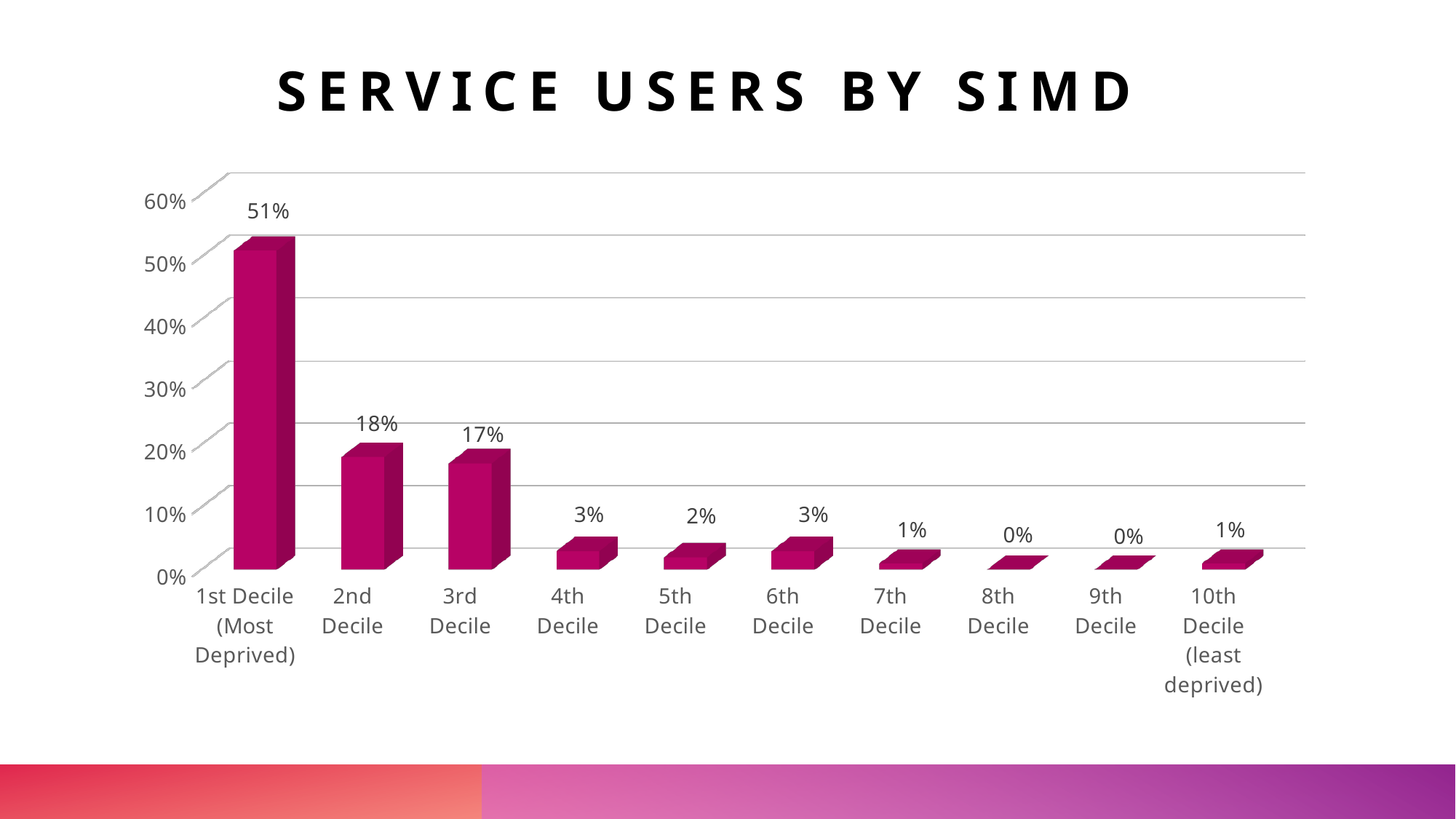
What kind of chart is shown on the slide? Bar chart Is the value for the 1st Decile greater or less than 50%? greater What percentage of service users are in the 1st Decile (Most Deprived)? 51% What is the difference between the values for the 2nd Decile and the 3rd Decile? 1% What is the value for the 3rd Decile? 17% How many deciles are shown on the x axis? 10 What is the value for the 5th Decile? 2% What is the title of the chart? Service Users by SIMD What is the difference between the values for the 1st Decile and the 2nd Decile? 33% What is the value for the 10th Decile (least deprived)? 1% Which is larger, the value for the 4th Decile or the 5th Decile? 4th Decile Which decile has the highest share of service users? 1st Decile (Most Deprived)